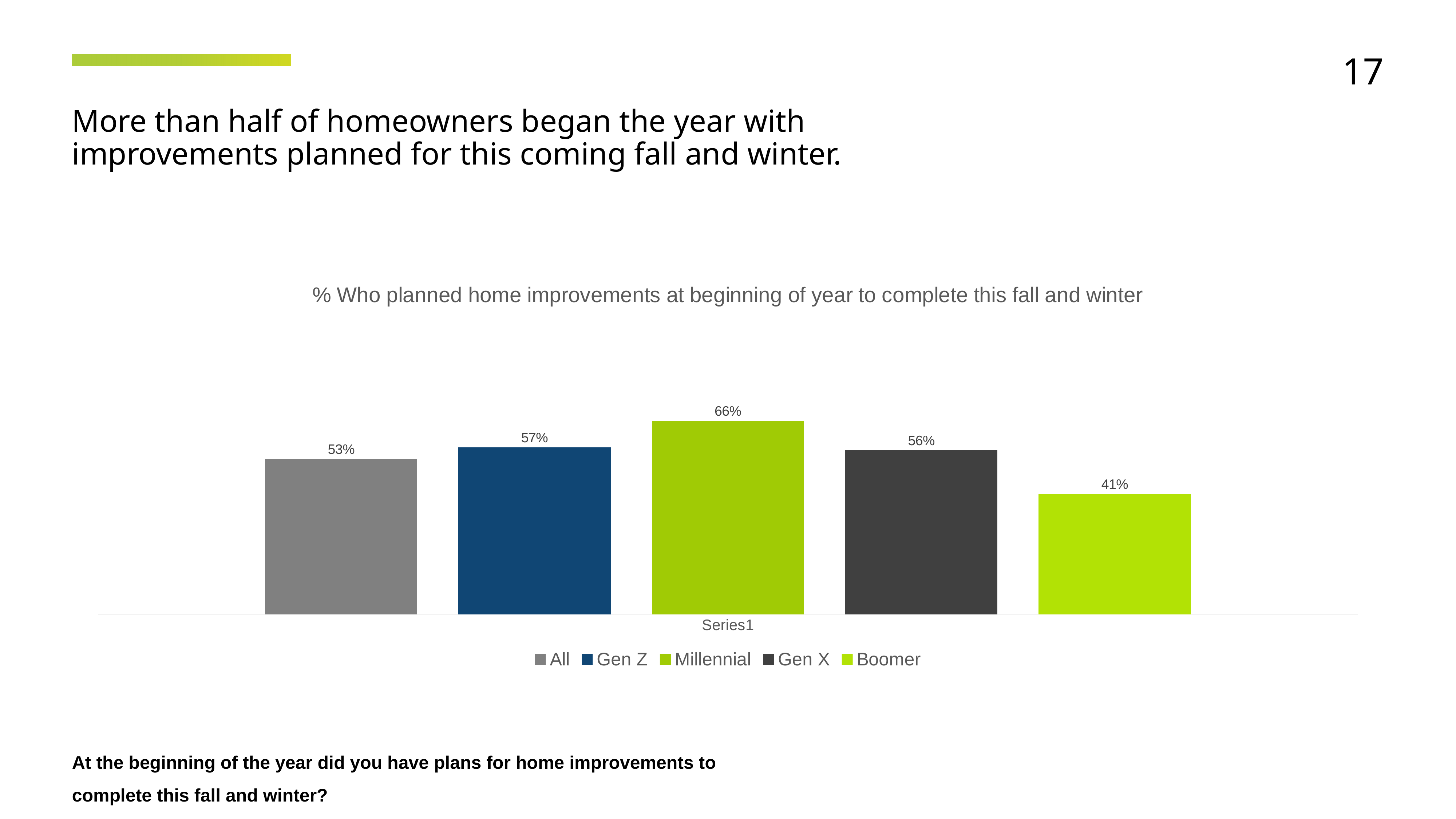
Which is larger, the value for Gen X or the value for All? Gen X Which group has the highest percentage who planned home improvements? Millennial How many entries does the legend list? 5 What kind of chart is shown on the slide? Bar chart What is the value shown for All homeowners in the chart? 53% How many bars are shown in the chart? 5 What is the title of the chart? % Who planned home improvements at beginning of year to complete this fall and winter What is the value shown for Boomer in the chart? 41% Which group has the lowest percentage who planned home improvements? Boomer What percentage of Gen Z homeowners planned home improvements at the beginning of the year to complete this fall and winter? 57% What is the difference between the Millennial and Boomer values? 25% What is the difference between the Gen Z and Gen X values? 1%